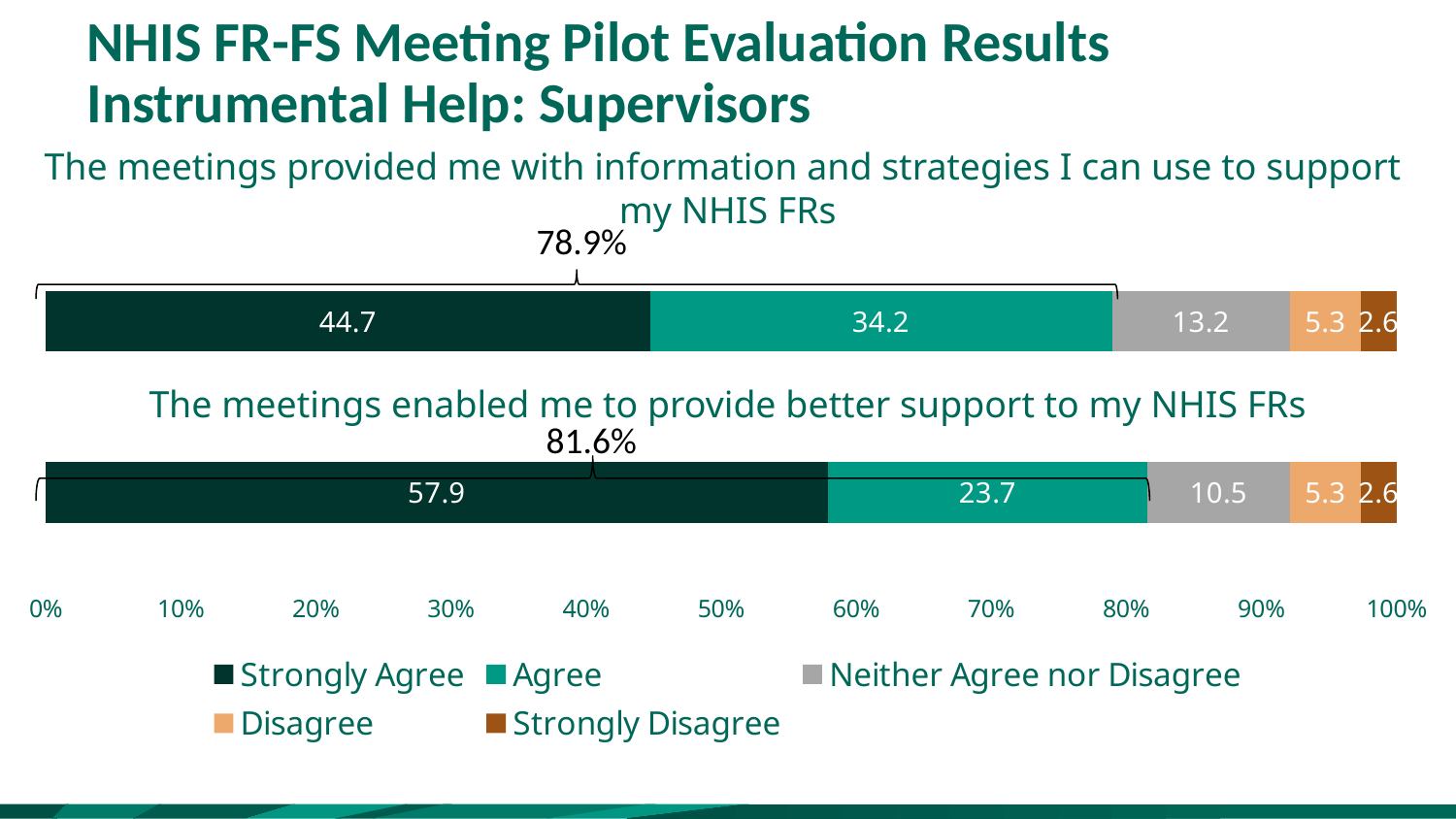
In the chart for "The meetings provided me with information and strategies I can use to support my NHIS FRs", what is the value for Neither Agree nor Disagree? 13.2 How many response categories does the legend list? 5 In the chart for "The meetings enabled me to provide better support to my NHIS FRs", is the Strongly Agree value greater or less than 50%? greater In the chart for "The meetings provided me with information and strategies I can use to support my NHIS FRs", which response category has the smallest value? Strongly Disagree In the chart for "The meetings enabled me to provide better support to my NHIS FRs", what is the combined percentage for Strongly Agree and Agree shown above the bar? 81.6% In the chart for "The meetings provided me with information and strategies I can use to support my NHIS FRs", what is the value for Strongly Agree? 44.7 What kind of chart is used on this slide? Stacked bar chart In the chart for "The meetings enabled me to provide better support to my NHIS FRs", what is the value for Disagree? 5.3 Which statement has the larger Agree value: "information and strategies" or "better support"? The meetings provided me with information and strategies I can use to support my NHIS FRs What is the difference between the Strongly Agree values of the two statements (57.9 for "better support" and 44.7 for "information and strategies")? 13.2 In the chart for "The meetings enabled me to provide better support to my NHIS FRs", which response category has the largest value? Strongly Agree In the chart for "The meetings enabled me to provide better support to my NHIS FRs", what is the value for Agree? 23.7